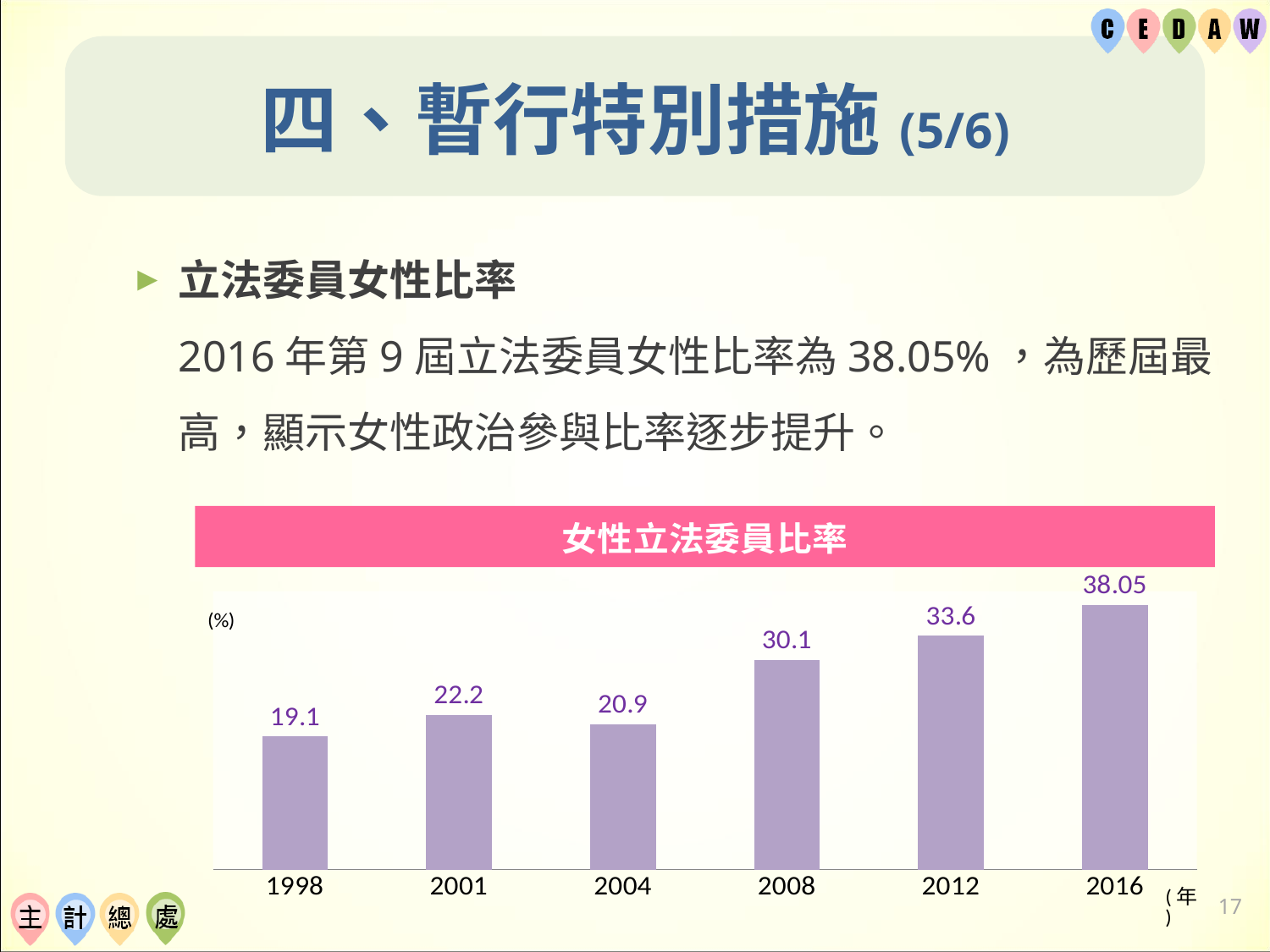
What kind of chart is shown on the slide? bar chart What is the difference between the values for 2008 and 2004? 9.2 What is the value for 2012 in the chart? 33.6 How many years are shown in the chart? 6 What is the value for 2004 in the chart? 20.9 What is the difference between the values for 2016 and 2012? 4.45 What is the value for 2016 in the 女性立法委員比率 chart? 38.05 Which year has the highest value in the chart? 2016 Which is larger, the value for 2001 or the value for 2004? 2001 What is the title of the chart? 女性立法委員比率 Which year has the lowest value in the chart? 1998 What is the value for 1998 in the chart? 19.1